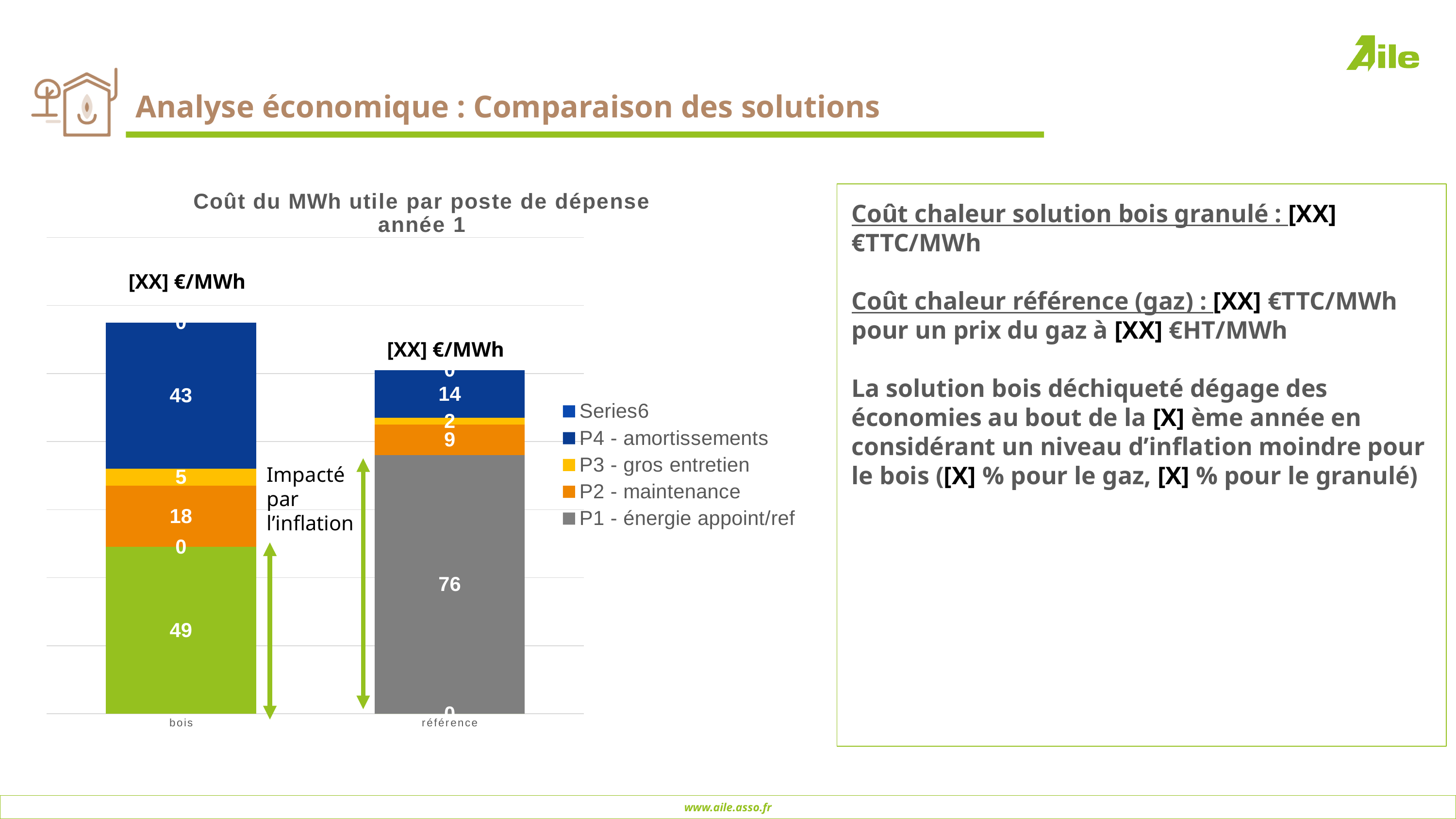
What is the value of P3 - gros entretien for référence? 2 How many series does the legend list? 5 Which category has the larger P4 - amortissements value, bois or référence? bois What is the value of P4 - amortissements for bois? 43 What kind of chart is shown? stacked bar chart What is the value of P1 - énergie appoint/ref for référence? 76 What is the value of P4 - amortissements for référence? 14 What is the value of P2 - maintenance for bois? 18 How many categories are shown on the x axis? 2 What is the difference between the P2 - maintenance values for bois and référence? 9 What is the difference between the P4 - amortissements values for bois and référence? 29 Which category has the taller stacked bar overall? bois